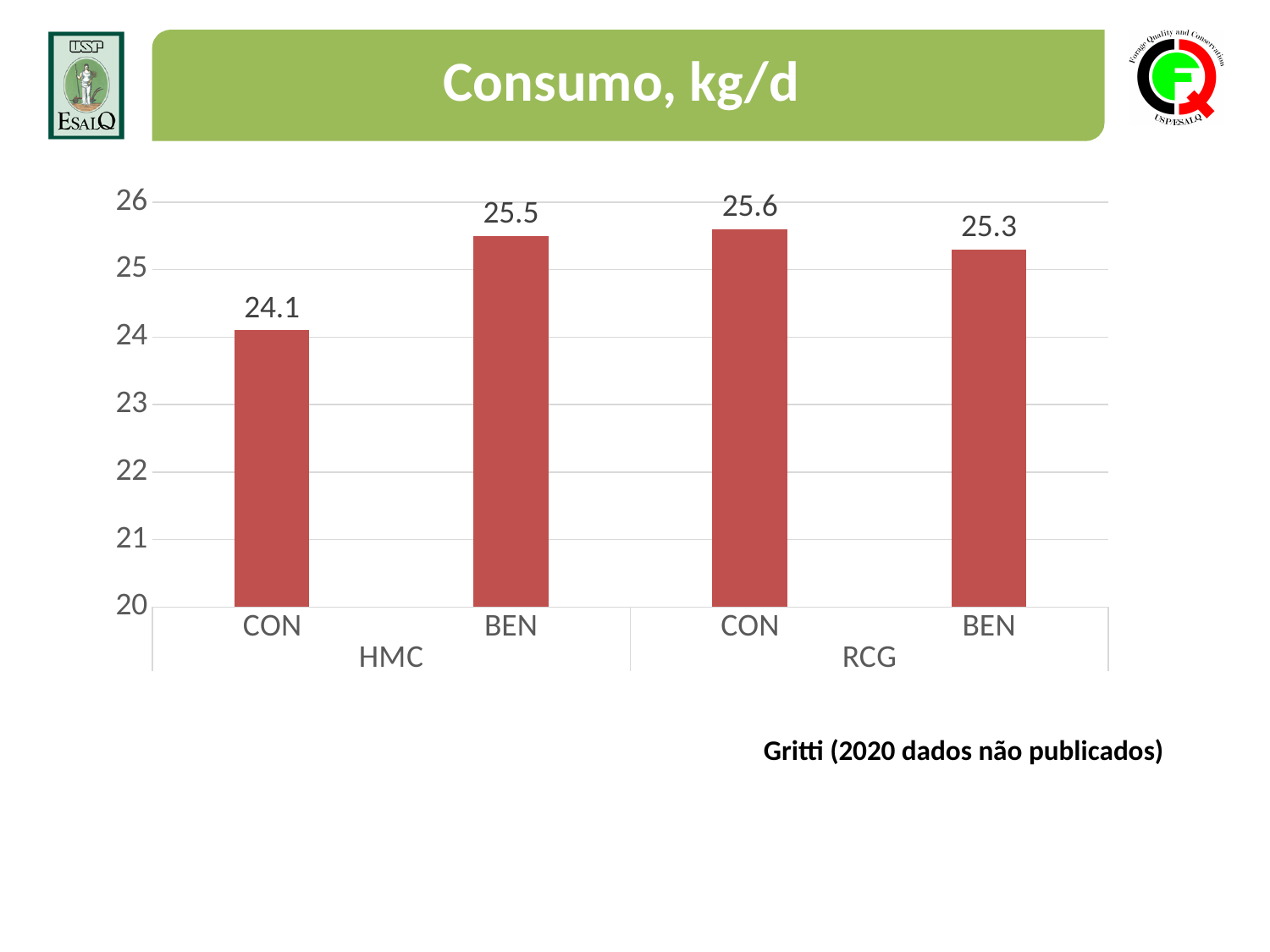
What is the difference between BEN and CON under HMC? 1.4 What kind of chart is shown on the slide? bar chart What is the title of the chart? Consumo, kg/d Is the value for CON under HMC greater or less than 25? less What is the value for BEN under RCG? 25.3 Which is larger, CON under HMC or BEN under HMC? BEN under HMC What is the value for CON under RCG? 25.6 Which bar has the lowest value? CON under HMC What is the value for CON under HMC? 24.1 What is the difference between CON and BEN under RCG? 0.3 How many bars are plotted in the chart? 4 What is the value for BEN under HMC? 25.5